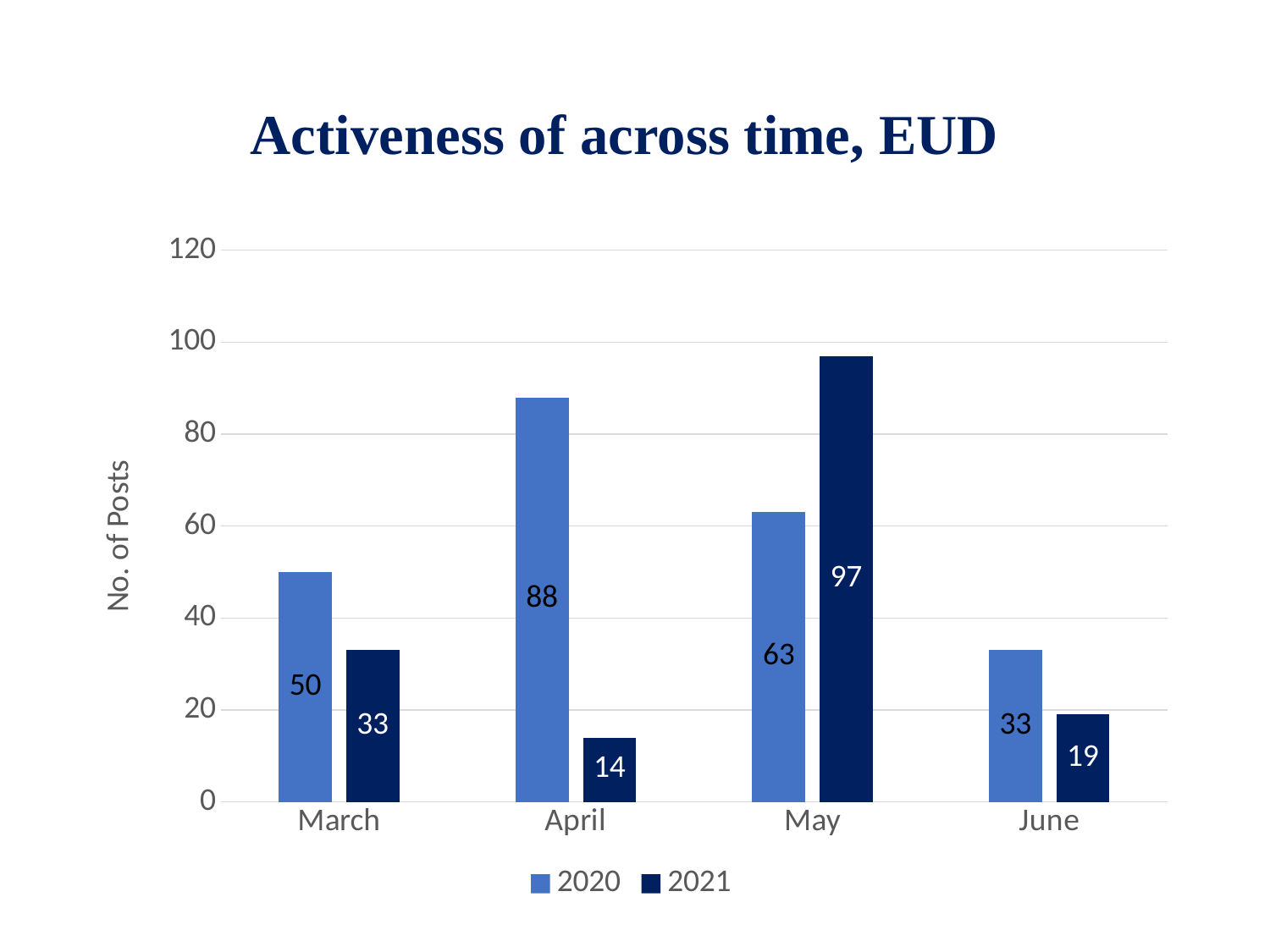
What is the difference between the 2020 and 2021 values in April? 74 How many series does the legend list? 2 What is the number of posts for 2021 in June? 19 Which month has the highest number of posts for the 2021 series? May Which is larger in March, the 2020 value or the 2021 value? 2020 Is the value for 2020 in May greater or less than 60? greater What kind of chart is shown on the slide? Bar chart What is the number of posts for 2021 in May? 97 What is the number of posts for 2020 in April? 88 Which month has the lowest number of posts for the 2020 series? June What is the label of the y axis? No. of Posts How many months are shown on the x axis? 4